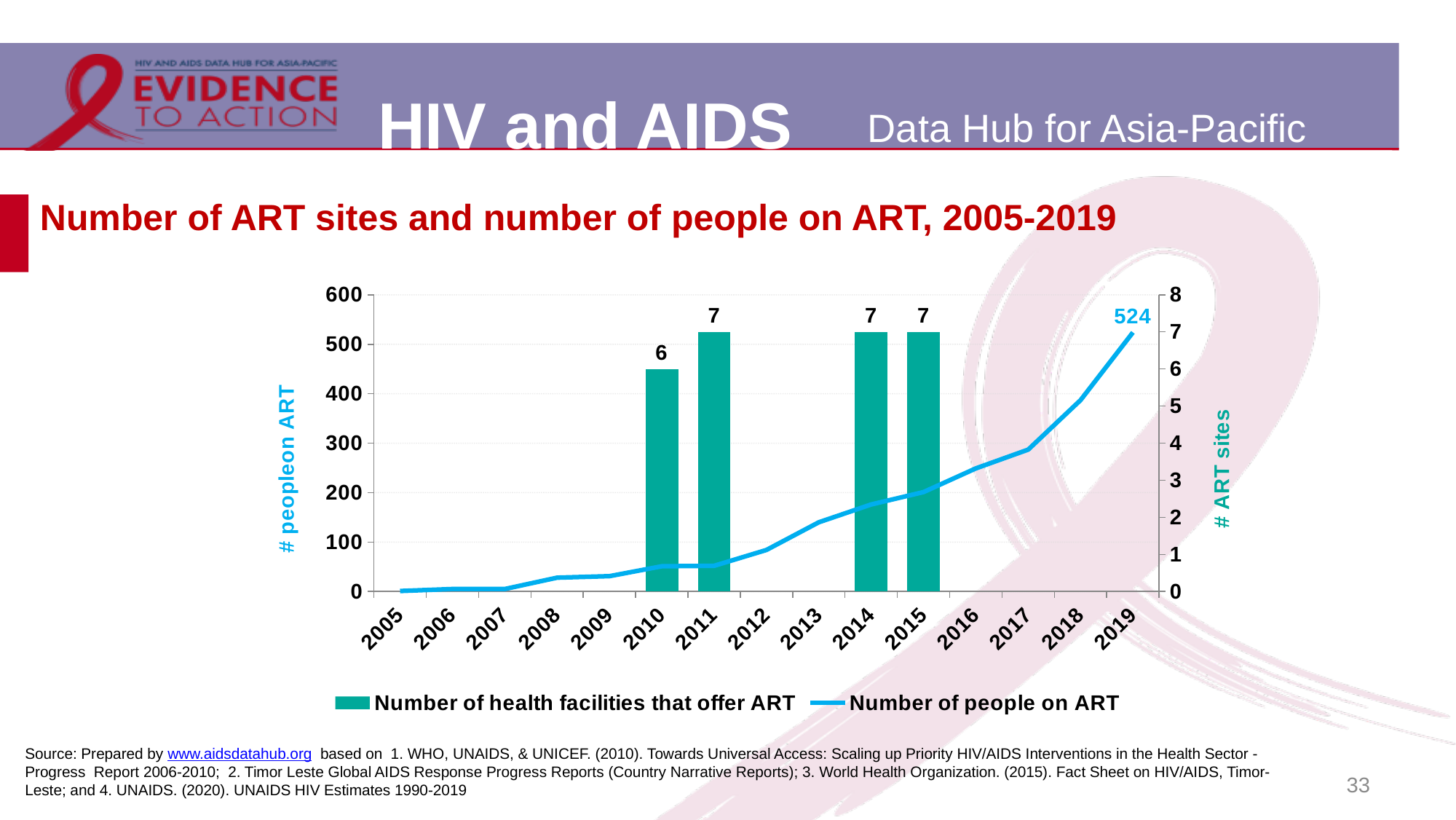
Which year has the lowest number of health facilities that offer ART among the years with a bar shown? 2010 What is the number of people on ART in 2019? 524 Is the number of people on ART in 2018 greater or less than 300? greater What is the number of health facilities that offer ART in 2011? 7 How many years are shown on the x axis? 15 What is the difference between the number of health facilities that offer ART in 2011 and in 2010? 1 How many series does the legend list? 2 Does the number of people on ART rise or fall from 2005 to 2019? rise Which is larger: the number of health facilities that offer ART in 2010 or in 2014? 2014 Is the number of people on ART in 2013 greater or less than 200? less What is the number of health facilities that offer ART in 2015? 7 What is the number of health facilities that offer ART in 2010? 6